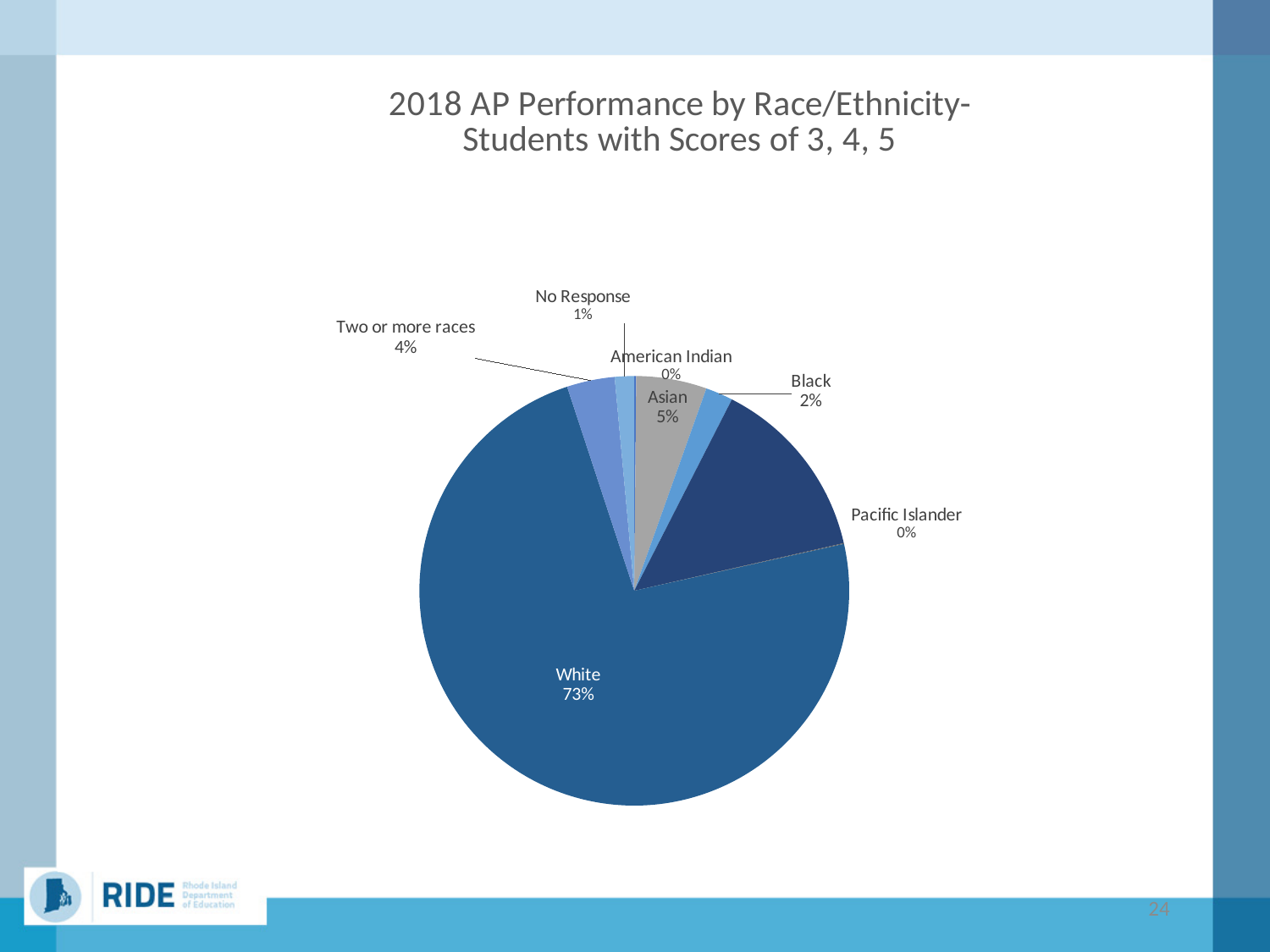
What is the difference between the Two or more races share and the No Response share? 3% Which is larger, the share for Asian or the share for Black? Asian What share of the pie does the White slice represent? 73% What is the value shown for Two or more races? 4% What is the value shown for Black? 2% What is the value shown for No Response? 1% What is the difference between the White share and the Asian share? 68% What is the value shown for Pacific Islander? 0% What kind of chart is shown on the slide? pie chart Which labeled category has the largest share of the pie? White What is the value shown for Asian? 5% What is the title of the chart? 2018 AP Performance by Race/Ethnicity- Students with Scores of 3, 4, 5